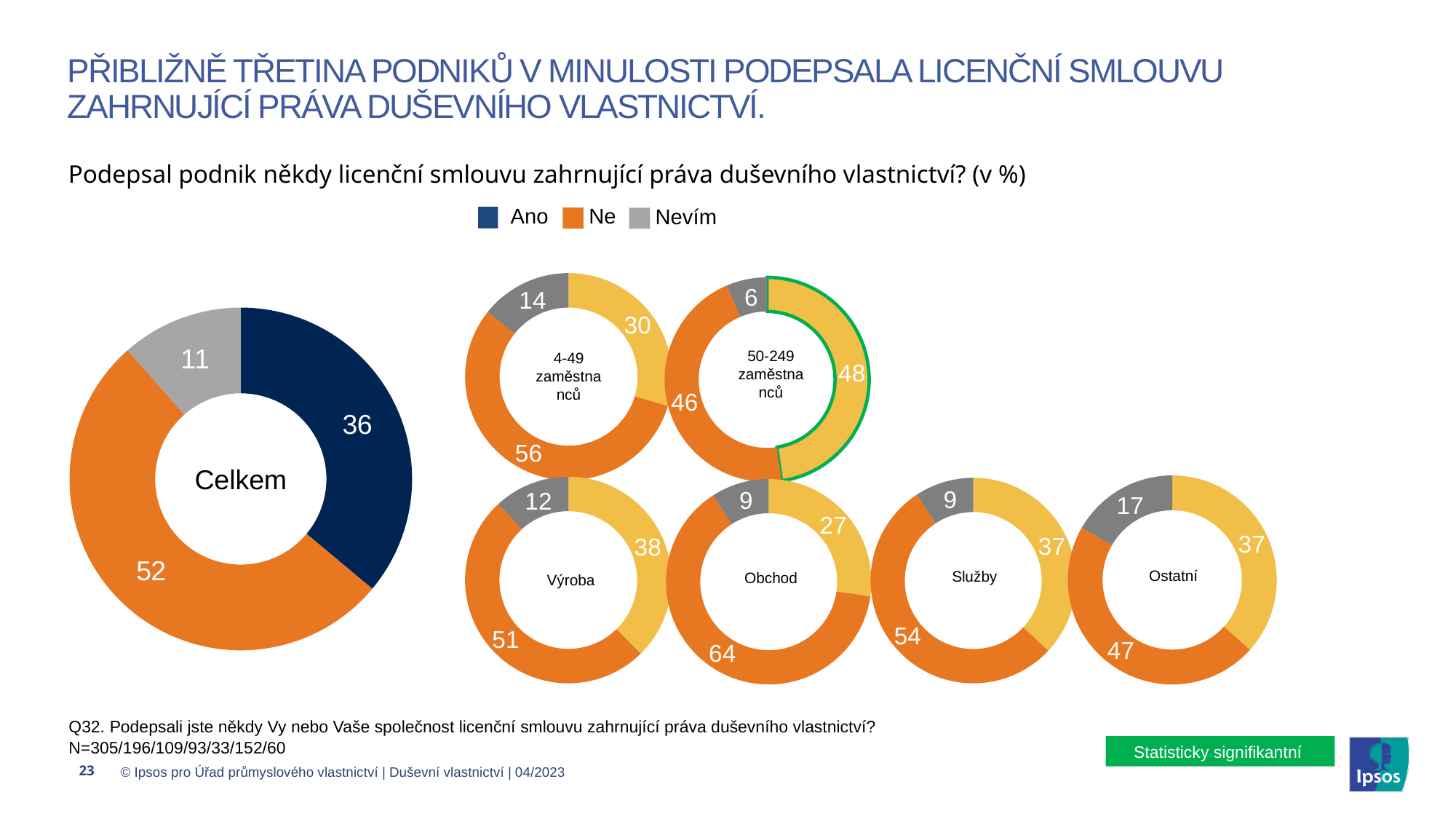
In the Celkem donut chart, what is the value for Ne? 52 Across the small donut charts, which group has the lowest value for Nevím (grey segment)? 50-249 zaměstnanců In the Obchod donut chart, what is the value for Ne (orange segment)? 64 Across the small donut charts, which group has the highest value for Ne (orange segment)? Obchod In the Celkem donut chart, what is the value for Nevím? 11 What kind of chart is used on this slide? Donut chart In the Ostatní donut chart, what is the value for Nevím (grey segment)? 17 In the 50-249 zaměstnanců donut chart, what is the value for Nevím (grey segment)? 6 Which is larger: the Ne value in the Služby chart or the Ne value in the Ostatní chart? Služby How many series does the legend list? 3 What is the difference between the Ne value in the Obchod chart and the Ne value in the Výroba chart? 13 In the Celkem donut chart, what is the value for Ano? 36